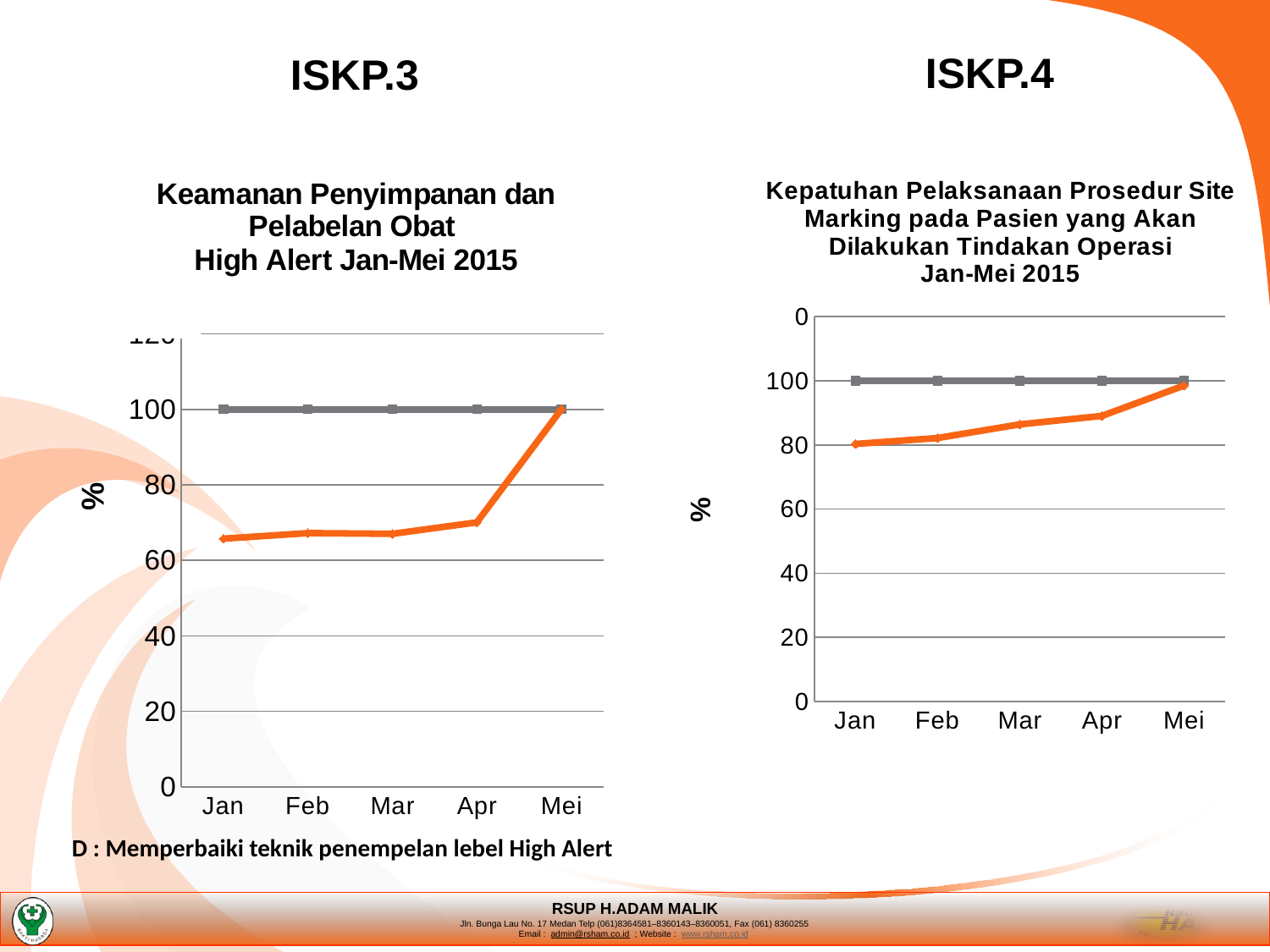
In the right chart (Kepatuhan Pelaksanaan Prosedur Site Marking), which is larger on the orange line, Jan or Apr? Apr In the left chart (Keamanan Penyimpanan dan Pelabelan Obat High Alert), which month has the highest value on the orange line? Mei What kind of chart is the right chart titled 'Kepatuhan Pelaksanaan Prosedur Site Marking pada Pasien yang Akan Dilakukan Tindakan Operasi Jan-Mei 2015'? line chart In the right chart (Kepatuhan Pelaksanaan Prosedur Site Marking), is the orange line's value for Jan greater or less than 60? greater In the left chart (Keamanan Penyimpanan dan Pelabelan Obat High Alert), does the orange line rise or fall from Apr to Mei? rise In the right chart (Kepatuhan Pelaksanaan Prosedur Site Marking), does the orange line rise or fall from Jan to Mei? rise How many months are plotted on the x axis of the left chart (Keamanan Penyimpanan dan Pelabelan Obat High Alert)? 5 In the left chart (Keamanan Penyimpanan dan Pelabelan Obat High Alert), is the orange line's value for Apr greater or less than 60? greater In the left chart (Keamanan Penyimpanan dan Pelabelan Obat High Alert), is the orange line's value for Jan greater or less than 80? less What kind of chart is the left chart titled 'Keamanan Penyimpanan dan Pelabelan Obat High Alert Jan-Mei 2015'? line chart In the left chart (Keamanan Penyimpanan dan Pelabelan Obat High Alert), what value does the flat gray line sit at? 100 In the right chart (Kepatuhan Pelaksanaan Prosedur Site Marking), which month has the lowest value on the orange line? Jan